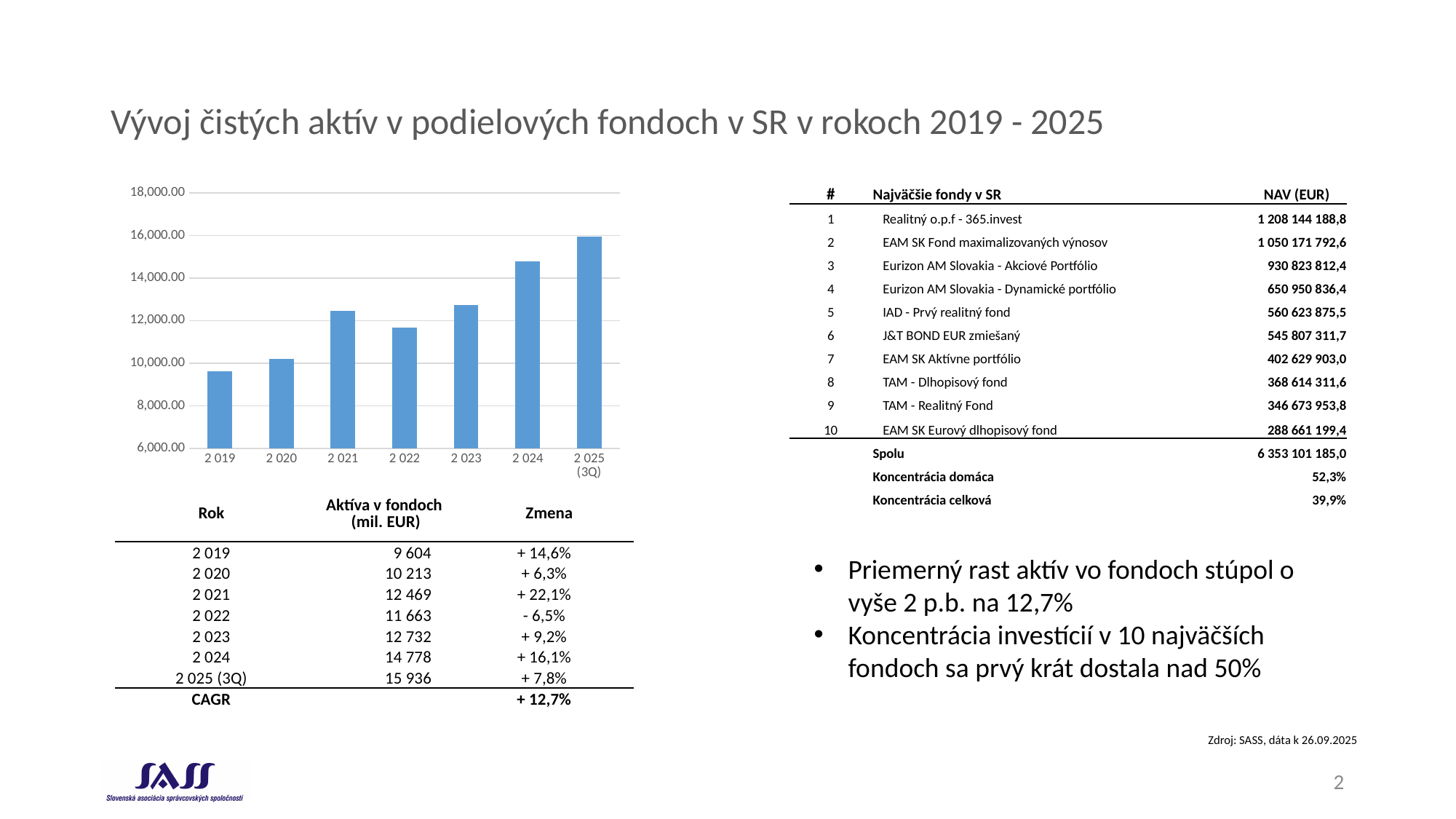
What is the highest value shown on the chart's vertical axis? 18,000.00 Is the value for 2 022 greater or less than 12,000.00? less Which bar is taller, 2 021 or 2 022? 2 021 Overall, do the values rise or fall from 2 019 to 2 025 (3Q)? rise Which year has the highest bar in the chart? 2 025 (3Q) Is the value for 2 019 greater or less than 10,000.00? less Is the value for 2 024 greater or less than 14,000.00? greater How many years (bars) are plotted in the chart? 7 Does the bar for 2 022 rise or fall compared with 2 021? fall What kind of chart is shown on the slide? bar chart Which year has the lowest bar in the chart? 2 019 Which bar is taller, 2 020 or 2 023? 2 023